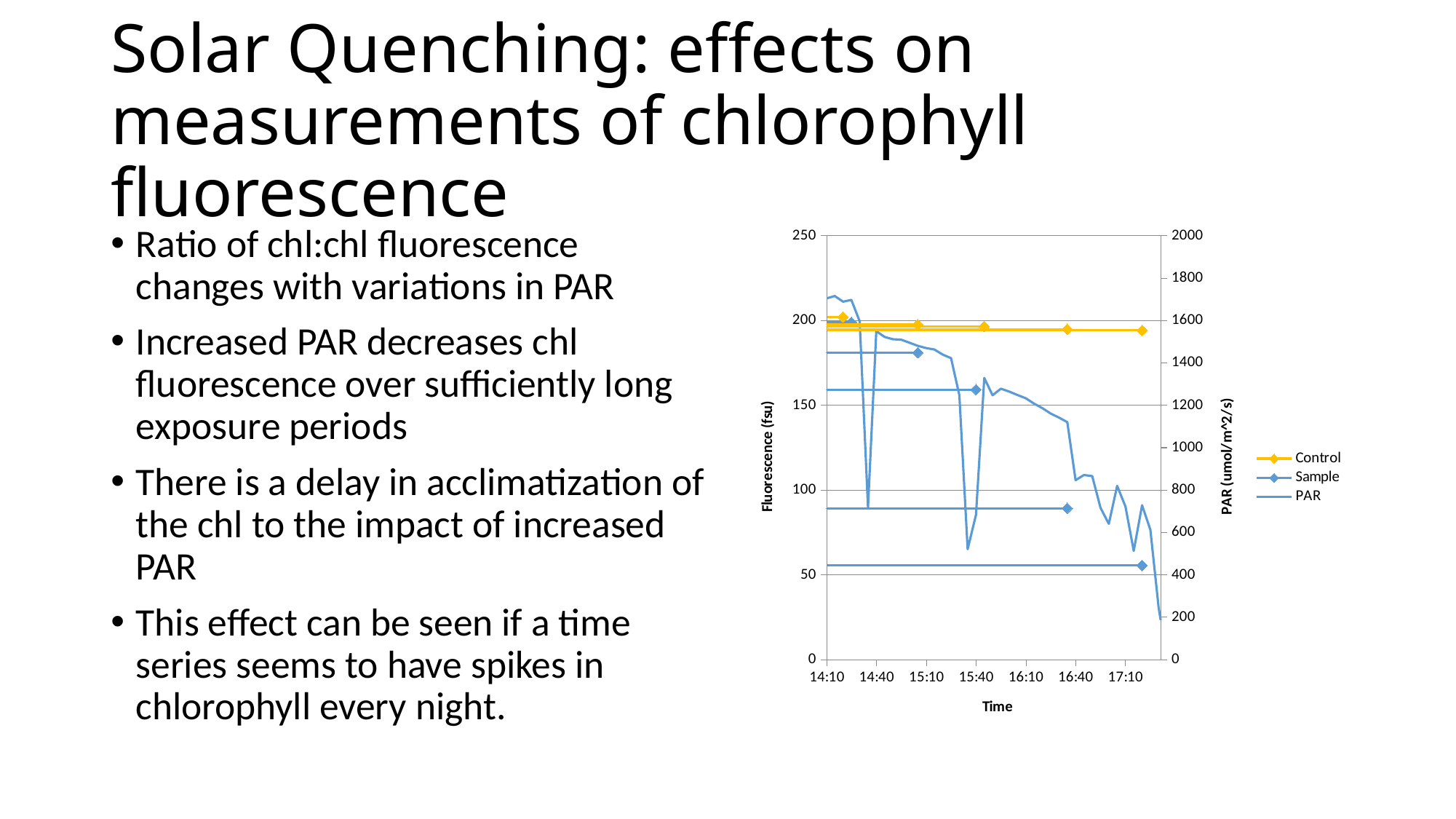
How many marked data points does the Sample series have? 5 Does the PAR series rise or fall over time along the x axis? fall What kind of chart is shown on the slide? line chart At the end of the time series (around 17:20), which is higher on the fluorescence axis, Control or Sample? Control Is the value of the Sample series at its last marker (around 17:20) greater or less than 100? less How many series does the chart legend list? 3 Is the value of the Control series at its last marker (around 17:20) greater or less than 150? greater Is the value of the Sample series at its first marker (around 14:20) greater or less than 150? greater Does the Sample series rise or fall over time along the x axis? fall What are the names of the series listed in the chart legend? Control, Sample, PAR What is the title of the left vertical axis of the chart? Fluorescence (fsu)